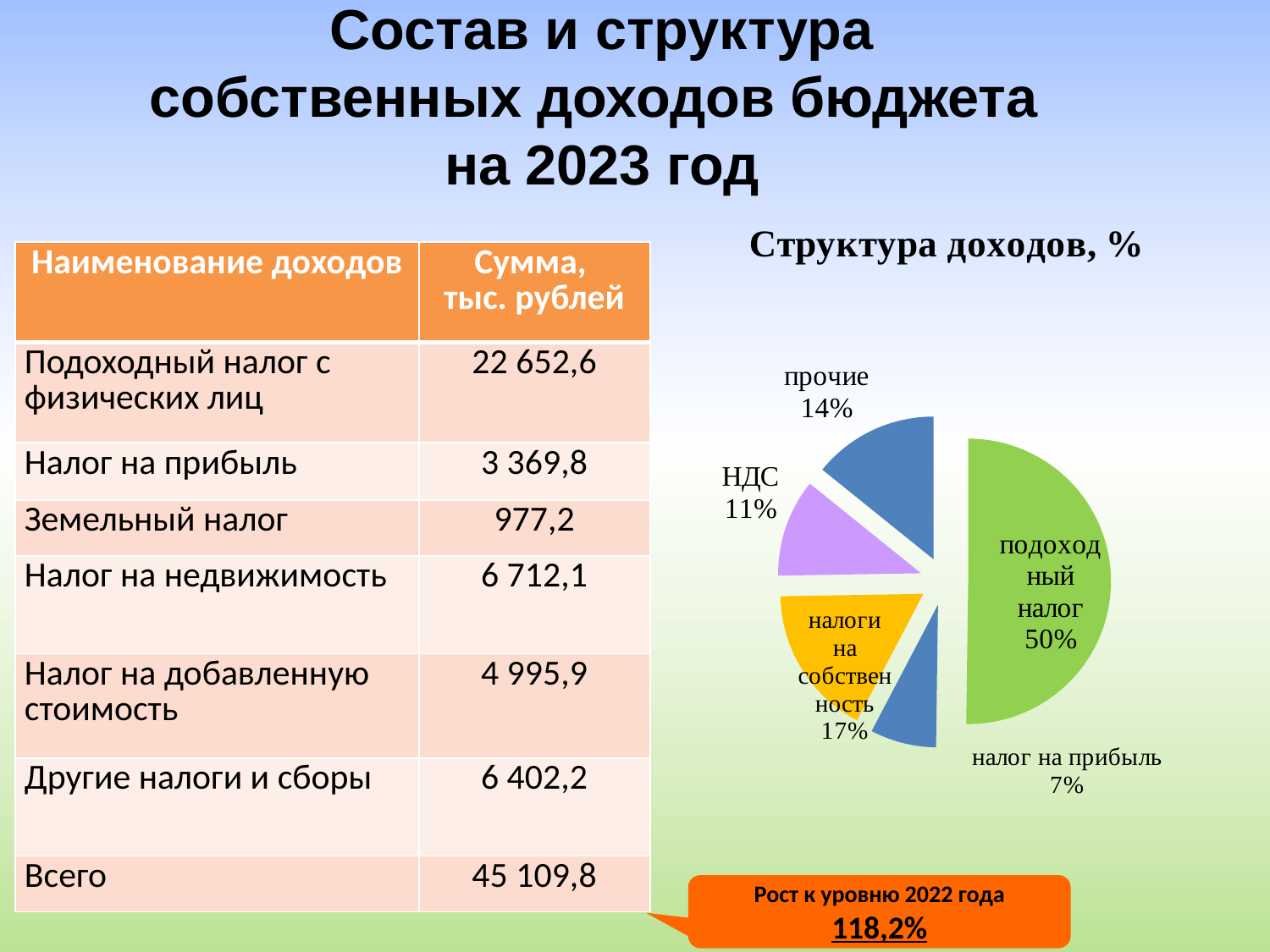
What share of the pie is прочие? 14% How many slices does the pie chart have? 5 What kind of chart is shown on the slide? pie chart Which is larger, the share for налоги на собственность or the share for прочие? налоги на собственность What share of the pie is налоги на собственность? 17% Which slice of the pie is the smallest? налог на прибыль What share of the pie is НДС? 11% Which slice of the pie is the largest? подоходный налог What share of the pie is налог на прибыль? 7% What is the title of the chart? Структура доходов, % What share of the pie is подоходный налог? 50% What is the difference in percentage points between the прочие slice and the НДС slice? 3